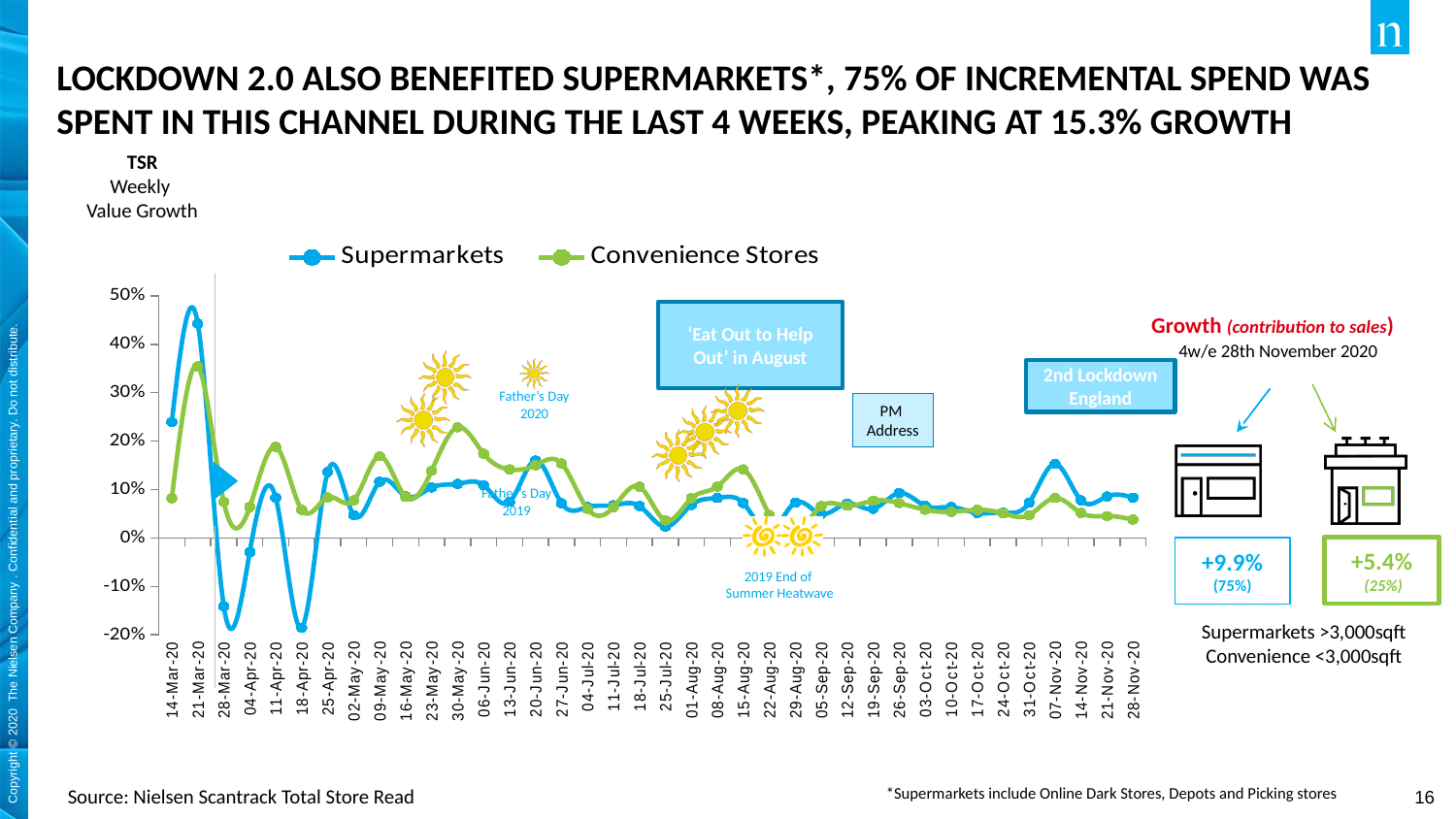
Is the Supermarkets value for 28-Mar-20 greater or less than -10%? less Is the Supermarkets value for 21-Mar-20 greater or less than 40%? greater Does the Supermarkets line rise or fall between 21-Mar-20 and 28-Mar-20? Fall What contribution to sales is shown for Convenience stores in the 4 weeks ending 28th November 2020? 25% Which series reaches the highest value anywhere on the chart? Supermarkets What type of chart is shown on the slide? Line chart What are the two series named in the chart legend? Supermarkets and Convenience Stores How many series does the chart legend list? 2 According to the panel on the right, what was the growth for Convenience stores in the 4 weeks ending 28th November 2020? +5.4% On 30-May-20, which series has the higher value, Supermarkets or Convenience Stores? Convenience Stores According to the panel on the right, what was the growth for Supermarkets in the 4 weeks ending 28th November 2020? +9.9% On 28-Mar-20, which series has the higher value, Supermarkets or Convenience Stores? Convenience Stores